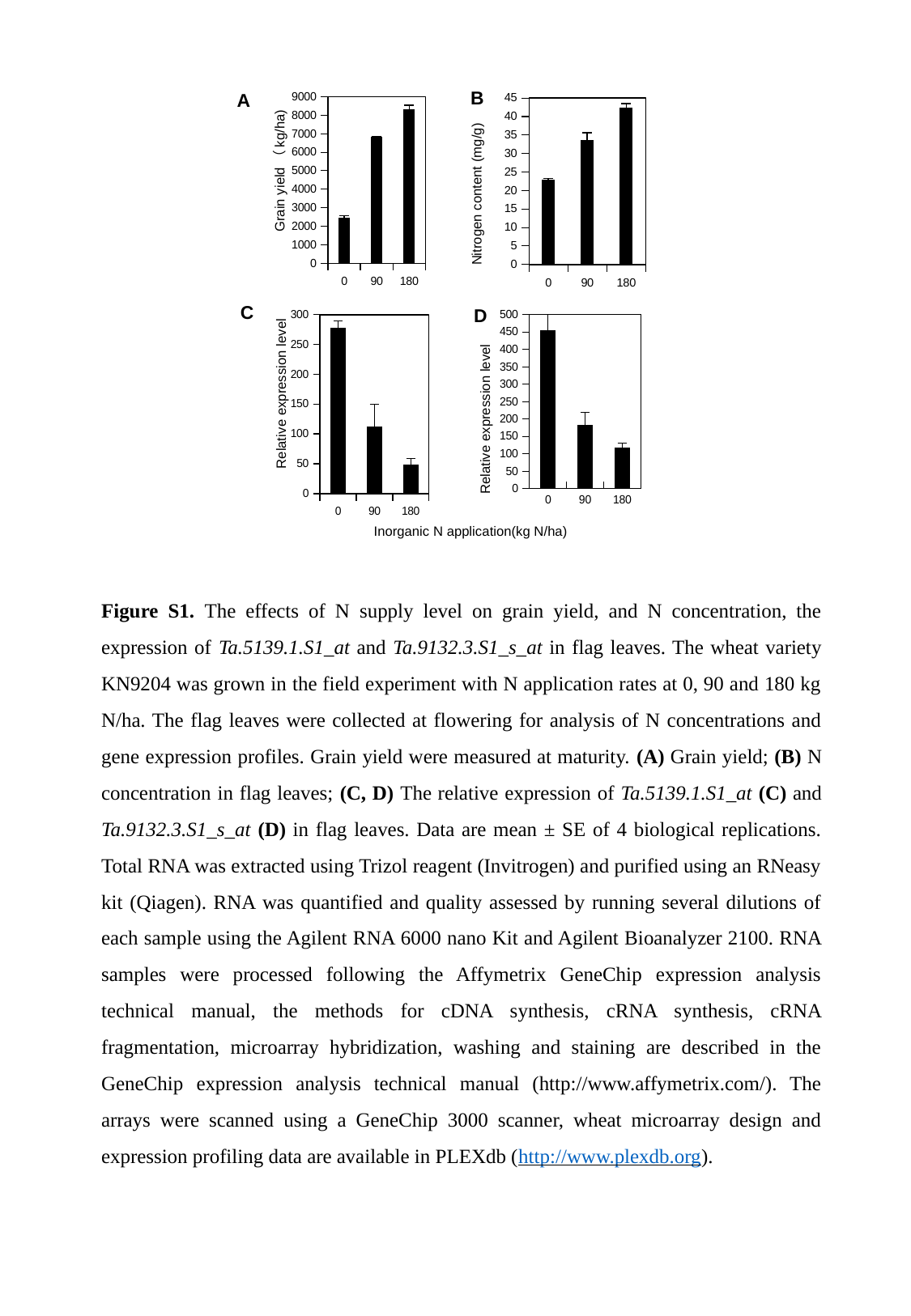
What kind of chart is chart A (Grain yield)? bar chart In chart A (Grain yield), which N application rate has the highest grain yield? 180 In chart D (Relative expression level), is the value for 0 kg N/ha greater or less than 400? greater In chart B (Nitrogen content), which N application rate has the lowest nitrogen content? 0 In chart C (Relative expression level), is the value for 0 kg N/ha greater or less than 250? greater In chart D (Relative expression level), which is larger, the value for 90 kg N/ha or the value for 180 kg N/ha? 90 In chart C (Relative expression level), do the values rise or fall as N application increases from 0 to 180? fall How many N application rates (categories) are shown on the x axis of chart D? 3 In chart B (Nitrogen content), do the values rise or fall as N application increases from 0 to 180? rise In chart B (Nitrogen content), is the value for 90 kg N/ha greater or less than 30? greater